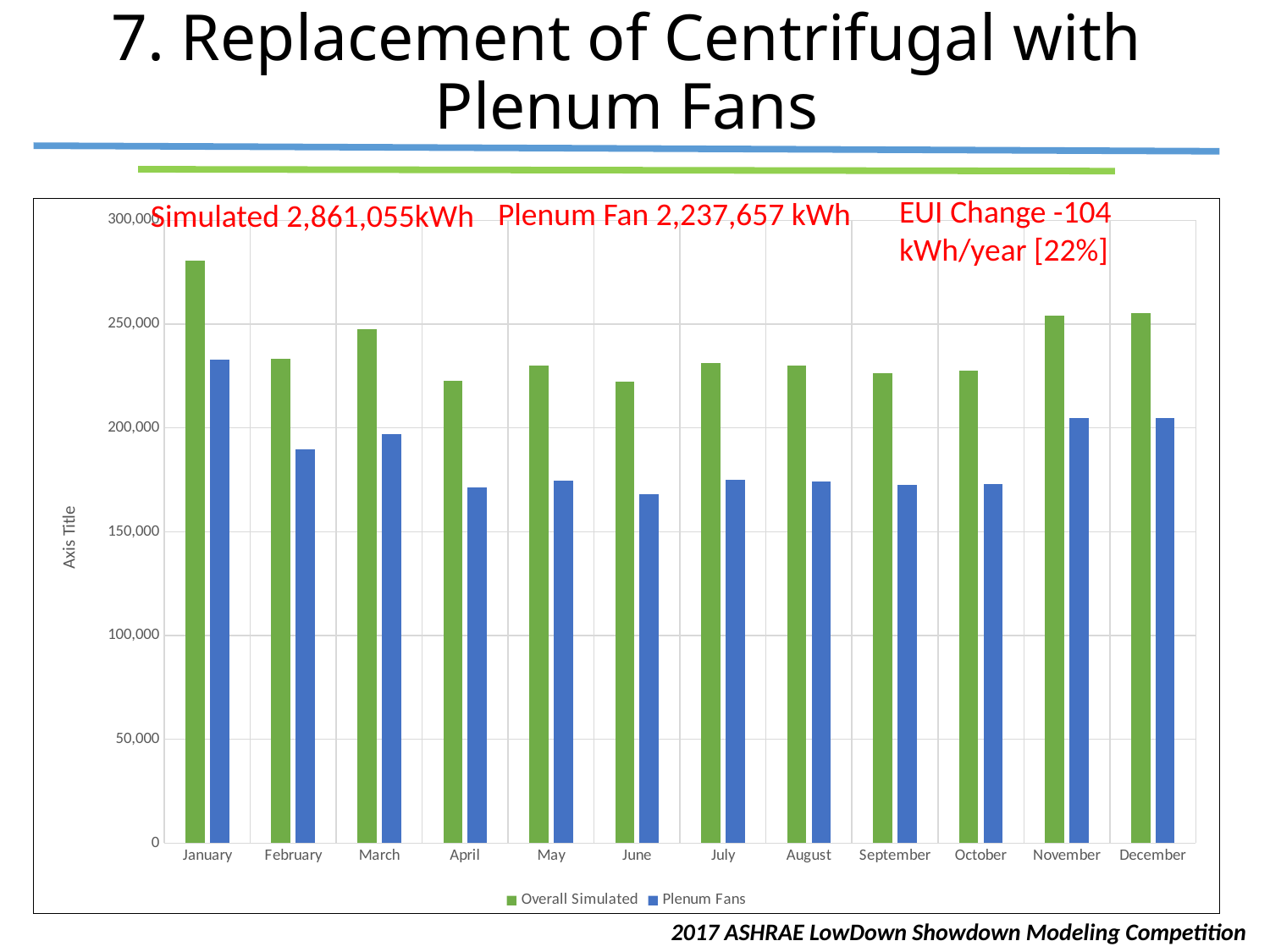
Which is larger in January: the Overall Simulated value or the Plenum Fans value? Overall Simulated Is the Overall Simulated value for January greater or less than 250,000? greater Is the Overall Simulated value for July greater or less than 200,000? greater Which month has the highest Overall Simulated value? January What are the two series named in the chart legend? Overall Simulated and Plenum Fans How many months are shown along the x axis of the chart? 12 How many series does the chart legend list? 2 Which month has the highest Plenum Fans value? January Is the Plenum Fans value for June greater or less than 200,000? less What kind of chart is shown on the slide? bar chart Which month has the larger Overall Simulated value, January or December? January